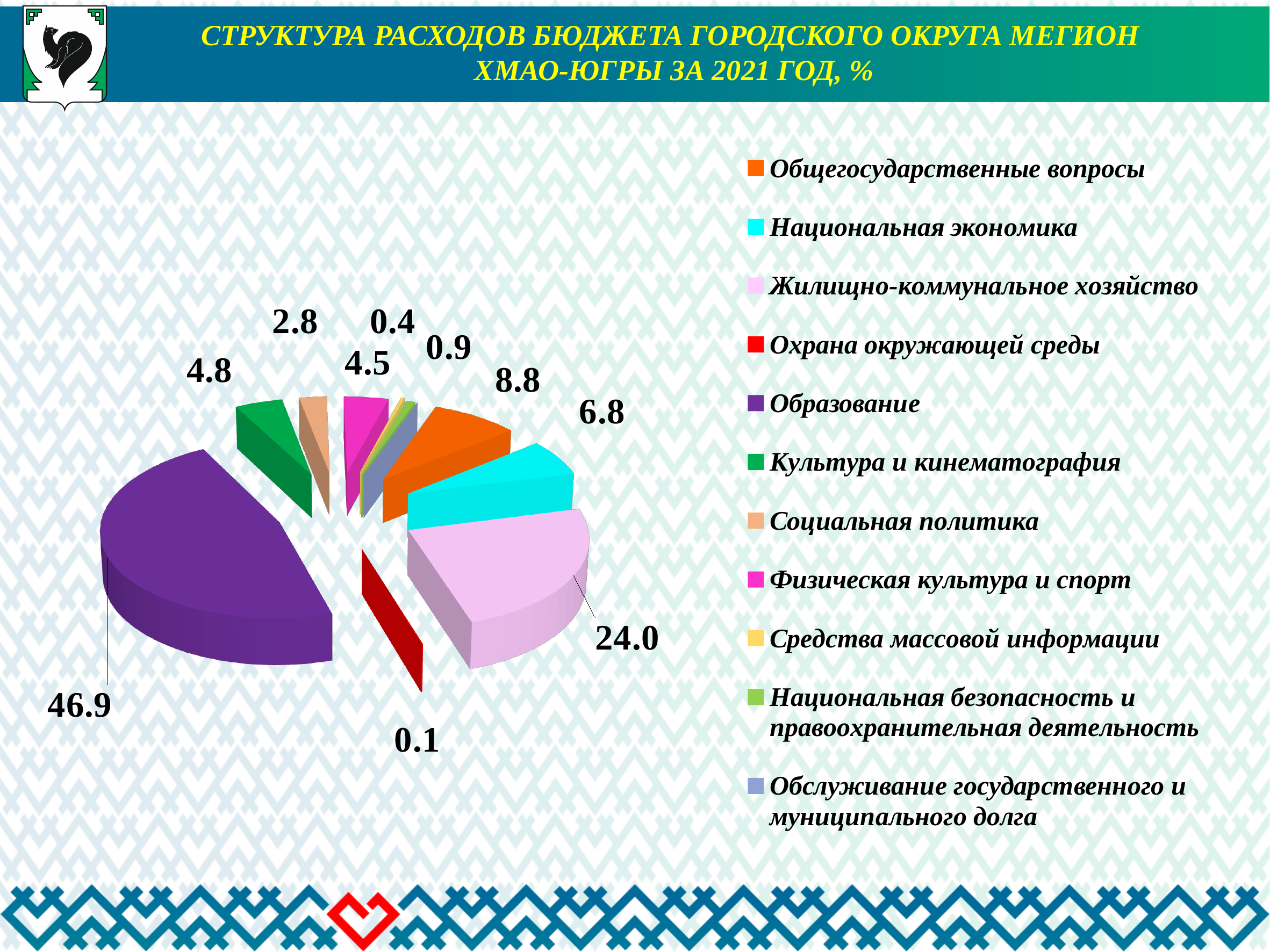
Which is larger, Общегосударственные вопросы or Национальная экономика? Общегосударственные вопросы What is the value for Национальная экономика? 6.8 What is the value for Социальная политика? 2.8 What is the value for Общегосударственные вопросы? 8.8 What is the value for Образование? 46.9 What is the value for Охрана окружающей среды? 0.1 What is the value for Жилищно-коммунальное хозяйство? 24.0 What kind of chart is shown on the slide? pie chart How many entries does the legend list? 11 What is the difference between the values for Образование and Жилищно-коммунальное хозяйство? 22.9 Which category has the largest share of the pie? Образование What is the value for Культура и кинематография? 4.8